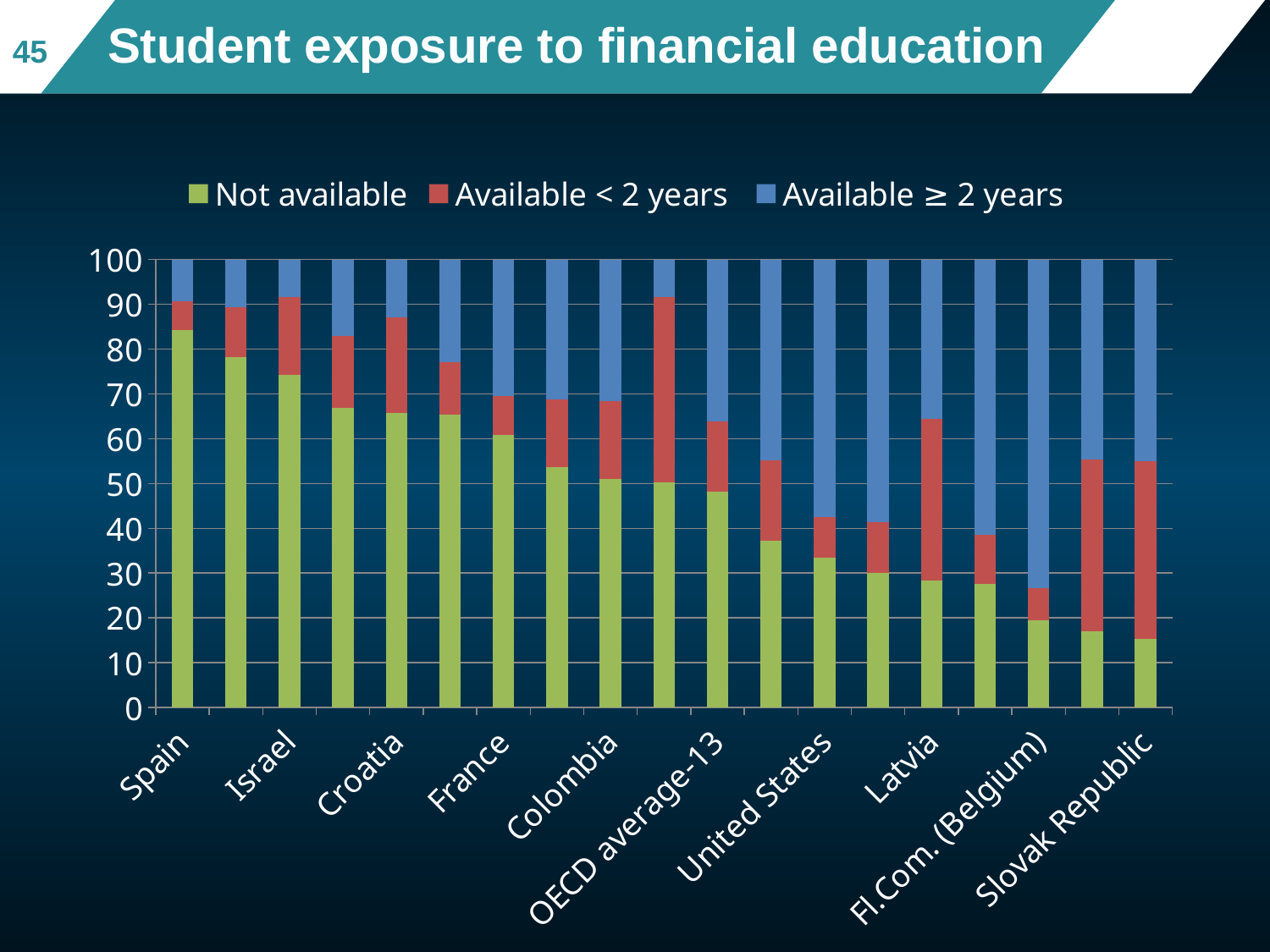
Is the 'Not available' value for Slovak Republic greater or less than 20? less Which has a larger 'Not available' value, Israel or Colombia? Israel Do the 'Not available' values rise or fall moving from left to right along the x axis? fall What colour represents 'Available ≥ 2 years' in the legend? Blue Which labelled country has the highest 'Not available' value? Spain Which labelled country has the lowest 'Not available' value? Slovak Republic Is the 'Not available' value for United States greater or less than 40? less What kind of chart is shown on the slide? Stacked bar chart How many bars are plotted in the chart? 19 Is the 'Not available' value for Spain greater or less than 80? greater How many series does the legend list? 3